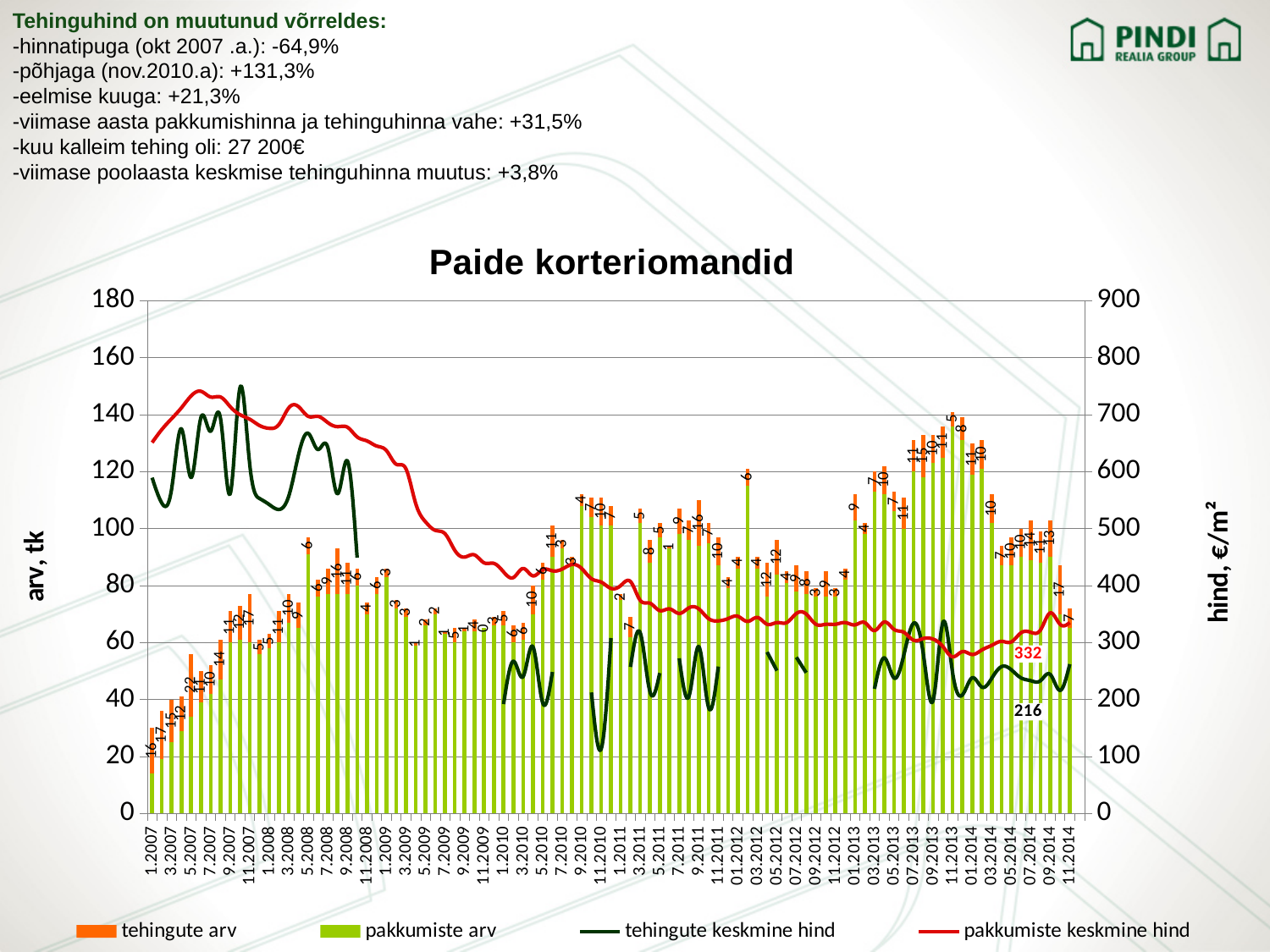
What kind of chart is shown on the slide? Combined bar and line chart Is the tehingute keskmine hind value at 11.2014 greater or less than 300? less Is the tallest pakkumiste arv bar greater or less than 120? greater What value is printed in red on the pakkumiste keskmine hind line near the right end of the chart? 332 What is the title of the chart? Paide korteriomandid How many series does the chart legend list? 4 Is the pakkumiste keskmine hind value at 1.2007 greater or less than 600? greater What value is printed in black on the tehingute keskmine hind line near the right end of the chart? 216 Does the pakkumiste keskmine hind line overall rise or fall from 2007 to 2014? fall At 11.2014, which is higher: pakkumiste keskmine hind or tehingute keskmine hind? pakkumiste keskmine hind Which series is drawn as a red line? pakkumiste keskmine hind What is the maximum value shown on the right-hand axis (hind, €/m²)? 900